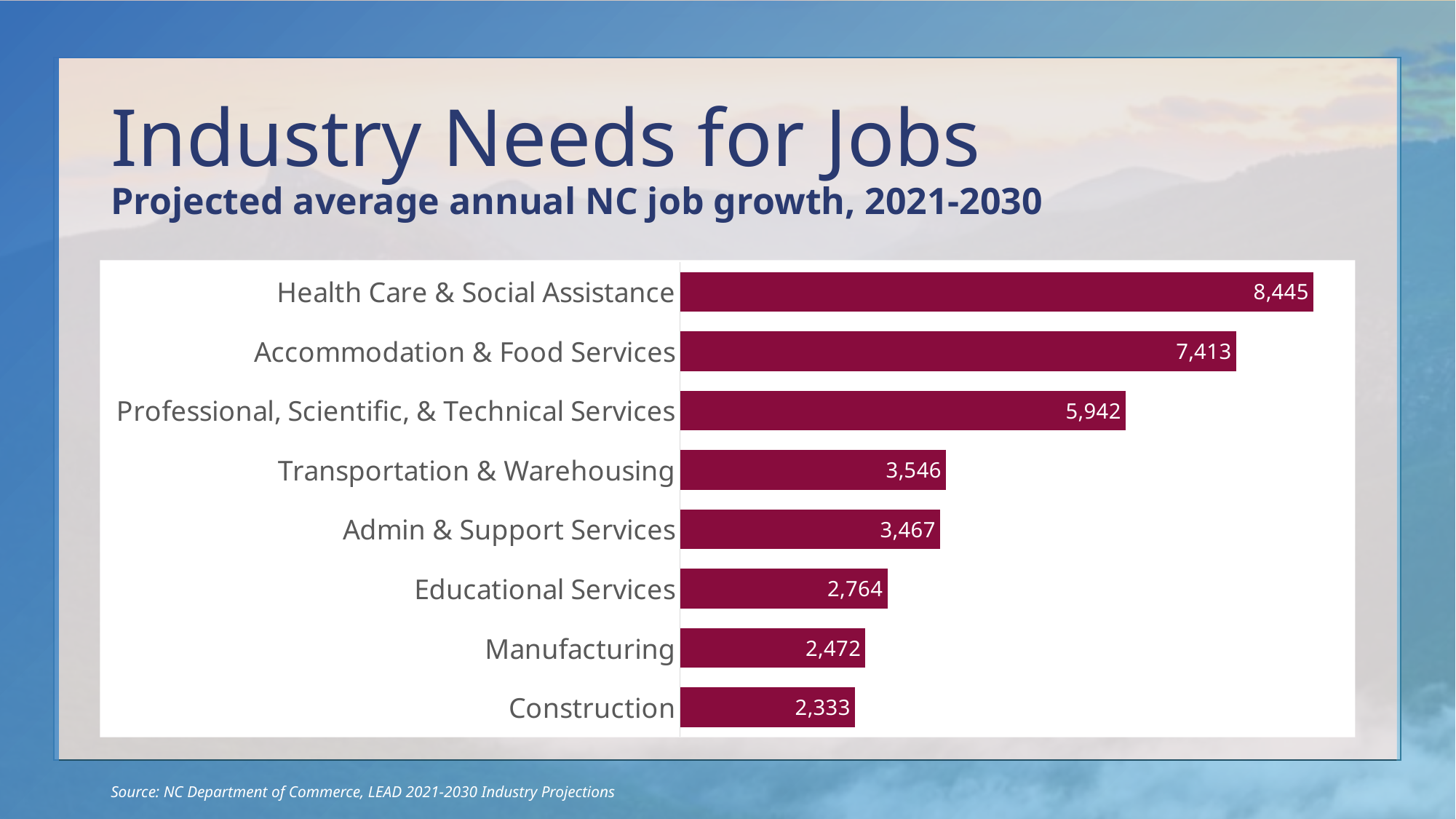
How many industries are shown in the chart? 8 What kind of chart is shown on the slide? Bar chart What is the difference between the values for Health Care & Social Assistance and Accommodation & Food Services? 1,032 Which is larger, the value for Manufacturing or the value for Construction? Manufacturing Which industry has the lowest projected average annual job growth? Construction What is the value shown for Transportation & Warehousing? 3,546 What is the subtitle of the chart on the slide? Projected average annual NC job growth, 2021-2030 Which is larger, the value for Professional, Scientific, & Technical Services or the value for Transportation & Warehousing? Professional, Scientific, & Technical Services What is the value shown for Construction? 2,333 Which industry has the highest projected average annual job growth? Health Care & Social Assistance What is the difference between the values for Educational Services and Manufacturing? 292 What is the projected average annual job growth for Health Care & Social Assistance? 8,445